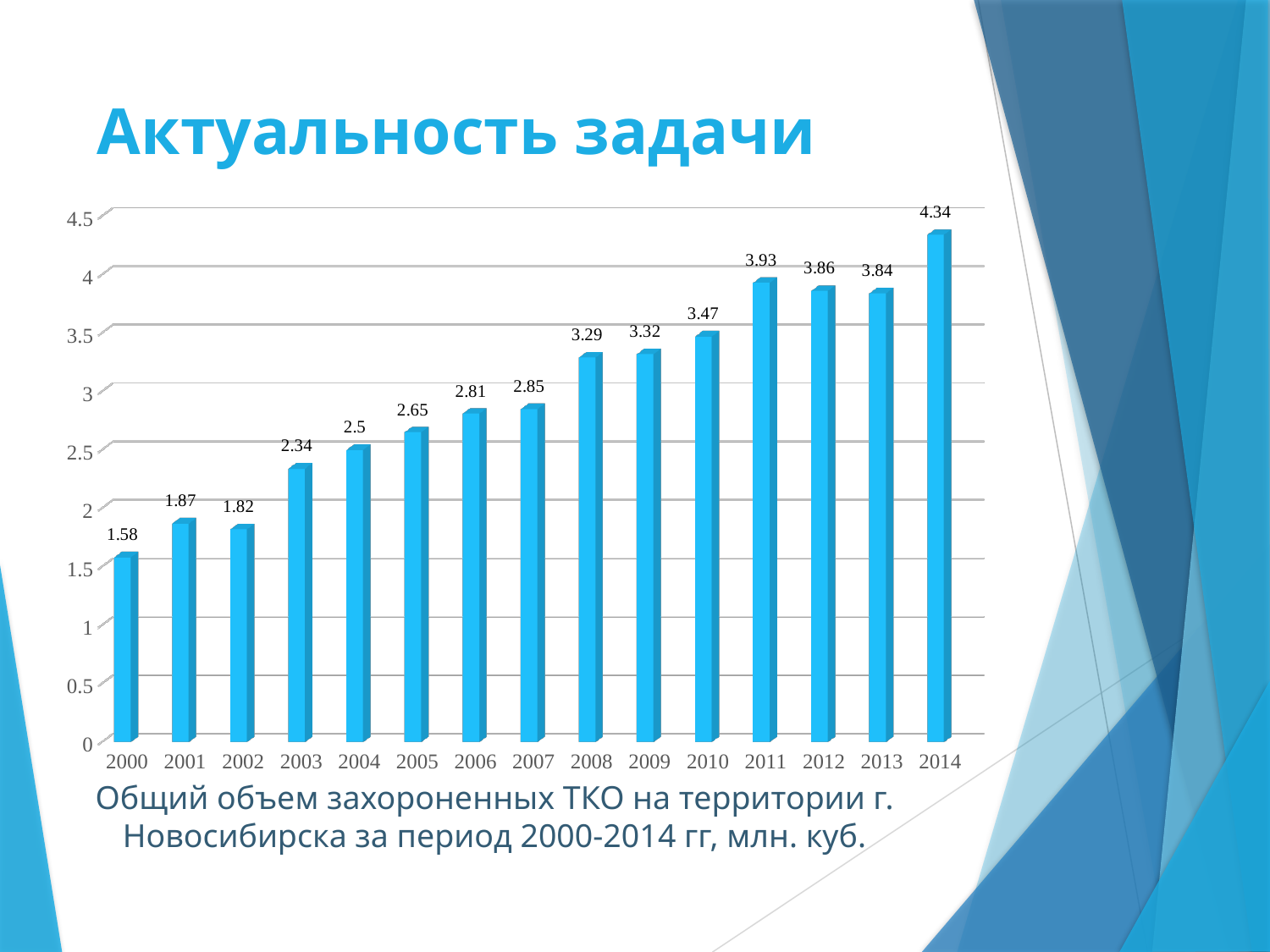
Which is larger, the value for 2003 or the value for 2006? 2006 What is the difference between the values for 2011 and 2010? 0.46 What is the value for 2008? 3.29 What is the value for 2014? 4.34 What is the value for 2000? 1.58 What is the difference between the values for 2014 and 2000? 2.76 What kind of chart is shown on the slide? bar chart Do the values generally rise or fall from 2000 to 2014? rise Which year has the lowest value? 2000 Which year has the highest value? 2014 How many years are shown on the x axis? 15 Is the value for 2009 greater or less than 3? greater